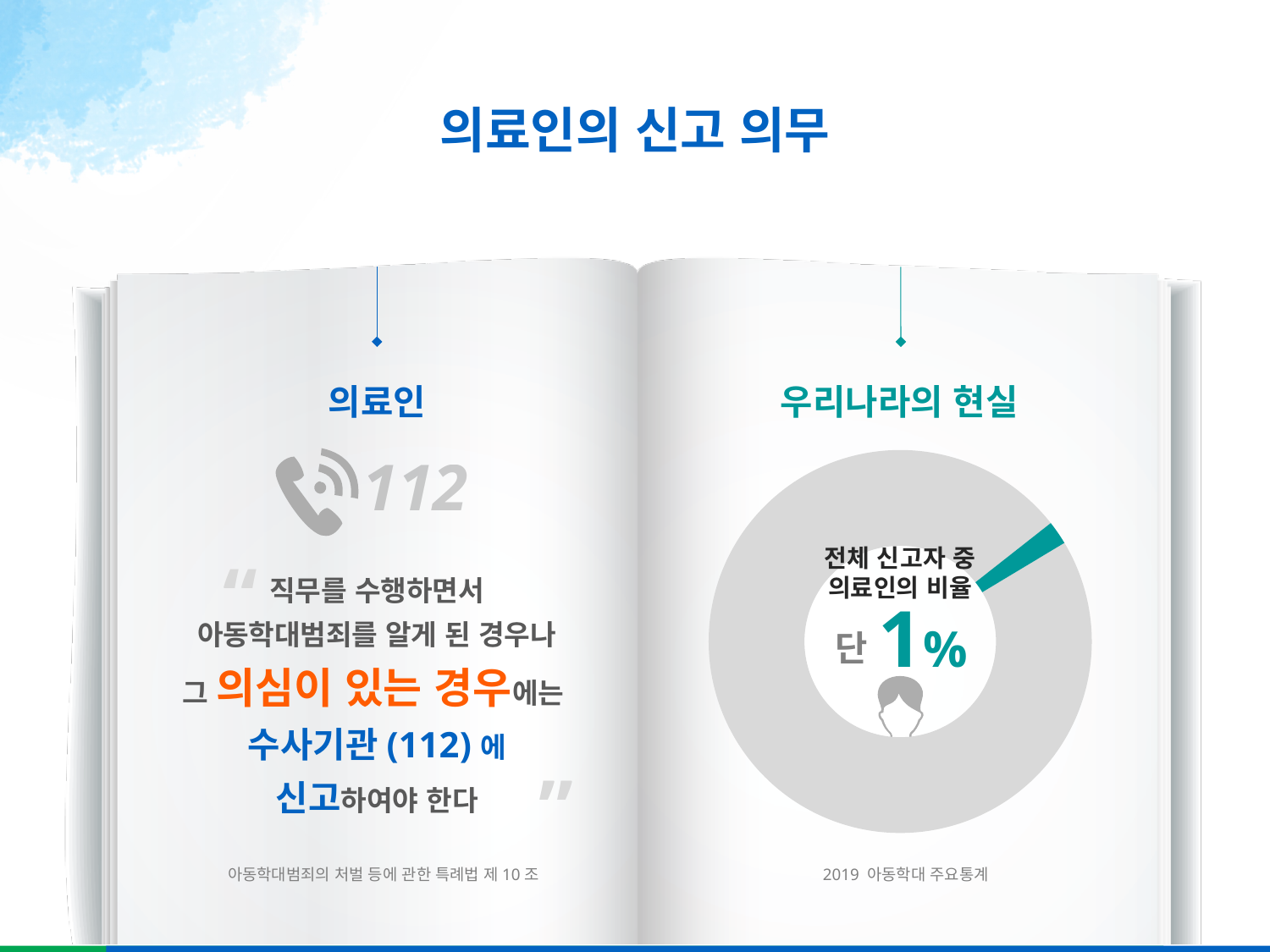
What kind of chart is shown on the right page of the slide? Donut (pie) chart In the donut chart, which is larger: the share of medical professionals or the share of all other reporters? All other reporters What does the highlighted teal slice of the donut chart represent? 전체 신고자 중 의료인의 비율 (share of medical professionals among all reporters) What source is cited below the donut chart? 2019 아동학대 주요통계 Is the share of medical professionals shown in the donut chart greater or less than 50%? less According to the donut chart, what share of all reporters are medical professionals (의료인)? 1% What is the heading above the donut chart? 우리나라의 현실 How many slices does the donut chart have? 2